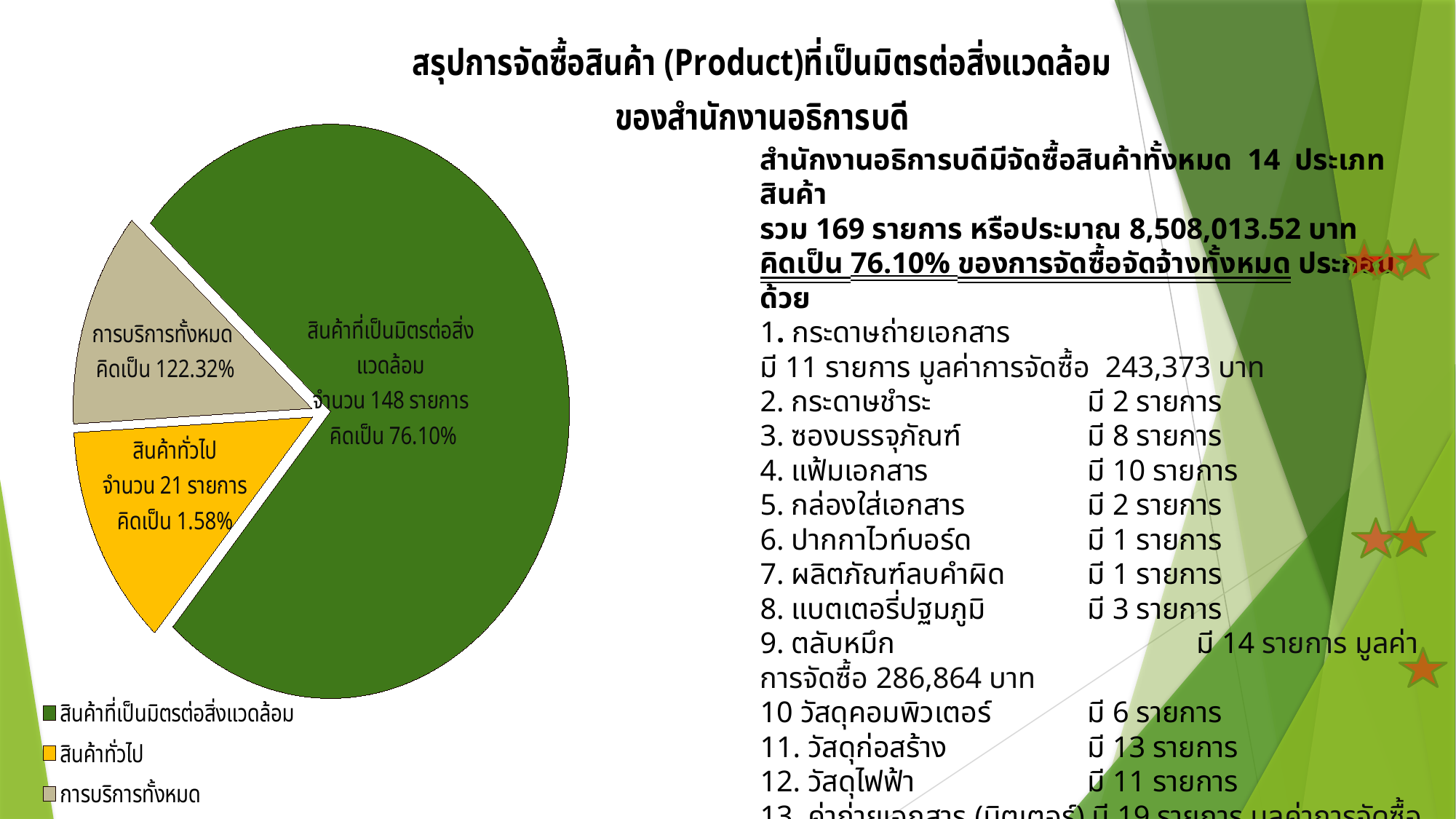
What percentage is printed on the สินค้าที่เป็นมิตรต่อสิ่งแวดล้อม slice? 76.10% What kind of chart is shown on the slide? pie chart Which has more items, สินค้าที่เป็นมิตรต่อสิ่งแวดล้อม or สินค้าทั่วไป? สินค้าที่เป็นมิตรต่อสิ่งแวดล้อม How many more items does สินค้าที่เป็นมิตรต่อสิ่งแวดล้อม have than สินค้าทั่วไป? 127 รายการ What percentage is printed on the สินค้าทั่วไป slice? 1.58% Which slice of the pie chart is the largest? สินค้าที่เป็นมิตรต่อสิ่งแวดล้อม What percentage is printed on the การบริการทั้งหมด slice? 122.32% What colour is the สินค้าทั่วไป slice in the pie chart? yellow How many entries does the legend of the pie chart list? 3 How many slices does the pie chart have? 3 How many items (รายการ) does the สินค้าที่เป็นมิตรต่อสิ่งแวดล้อม slice represent? 148 รายการ How many items (รายการ) does the สินค้าทั่วไป slice represent? 21 รายการ